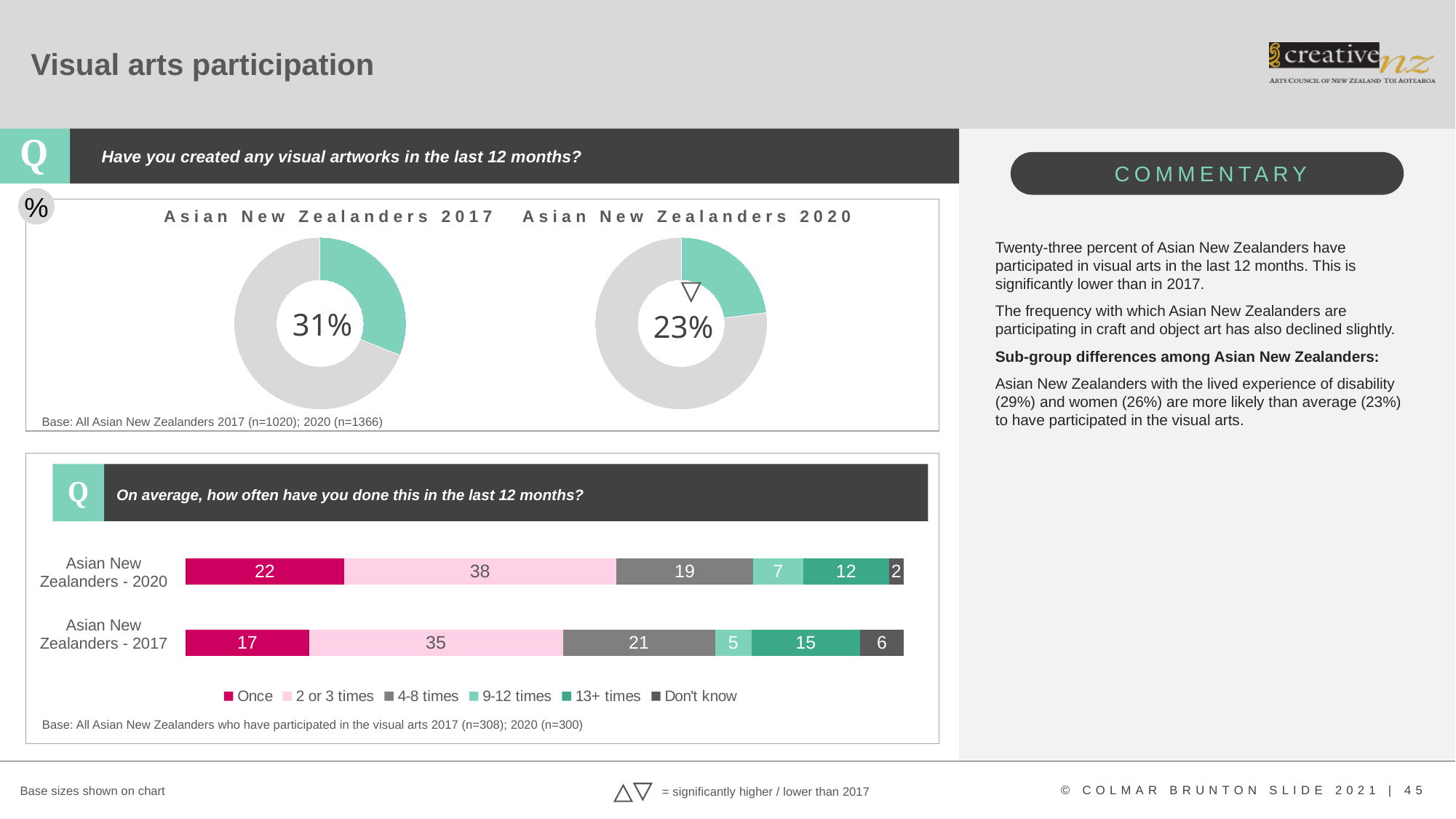
What is the difference in percentage points between the 2017 donut value and the 2020 donut value? 8 In the stacked bar chart at the bottom, how many series does the legend list? 6 What type of chart is used for the 'On average, how often have you done this in the last 12 months?' question? Stacked bar chart Comparing the two donut charts, which year shows the higher participation percentage, 2017 or 2020? 2017 In the donut chart titled 'Asian New Zealanders 2020', what percentage is shown in the centre? 23% In the stacked bar chart at the bottom, which segment is the largest for Asian New Zealanders - 2020? 2 or 3 times In the stacked bar chart at the bottom, what is the value for '13+ times' for Asian New Zealanders - 2020? 12 In the stacked bar chart at the bottom, what is the difference between the 'Don't know' values for 2017 and 2020? 4 In the stacked bar chart at the bottom, which segment is the smallest for Asian New Zealanders - 2017? 9-12 times In the stacked bar chart at the bottom, what is the value for 'Once' for Asian New Zealanders - 2020? 22 In the donut chart titled 'Asian New Zealanders 2017', what percentage is shown in the centre? 31% In the stacked bar chart at the bottom, what is the value for '2 or 3 times' for Asian New Zealanders - 2017? 35